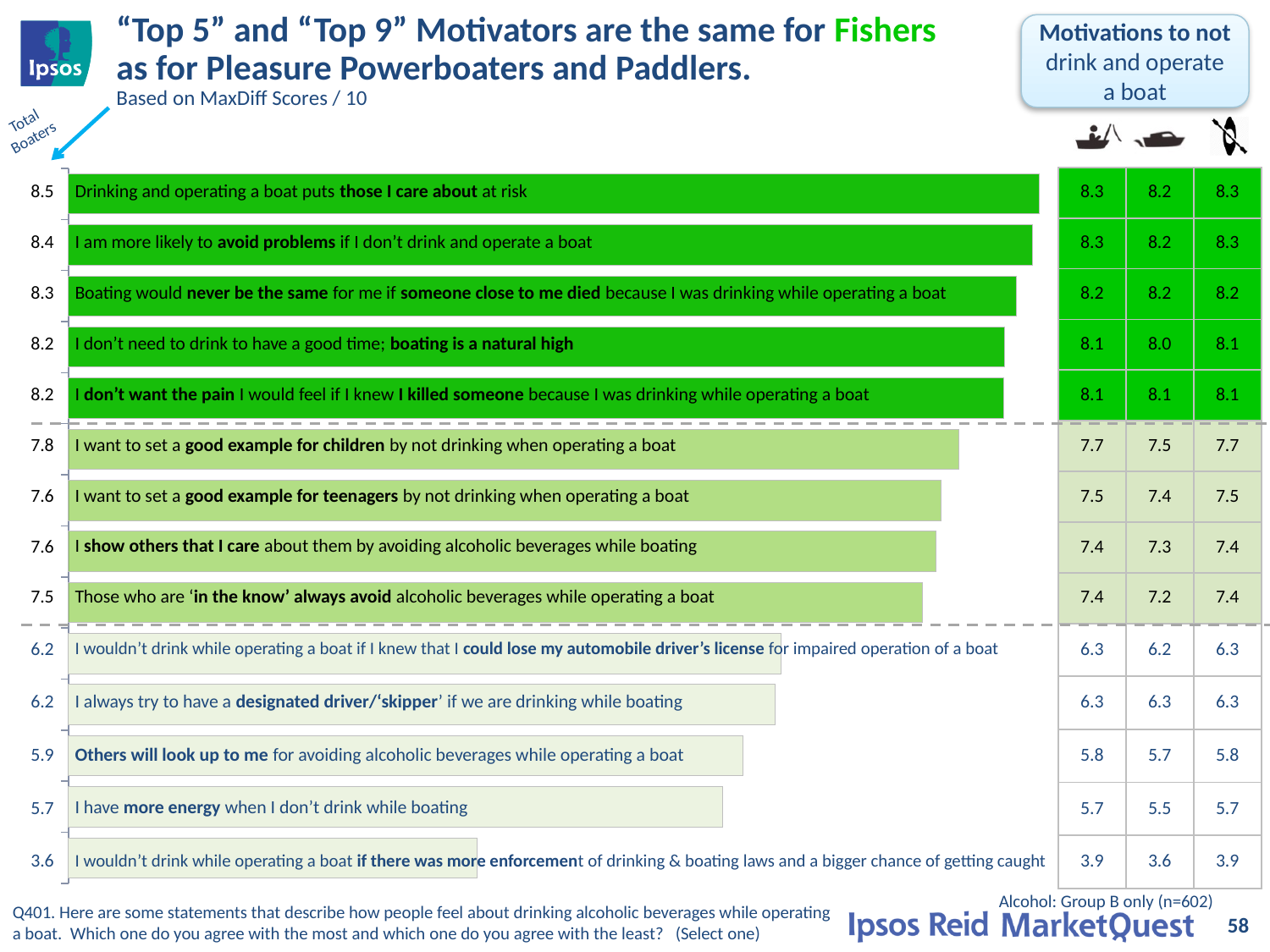
What is the Total Boaters score for 'I want to set a good example for children by not drinking when operating a boat'? 7.8 How many statements (bars) are plotted in the chart? 14 Which statement has the lowest Total Boaters score? I wouldn't drink while operating a boat if there was more enforcement of drinking & boating laws and a bigger chance of getting caught Which statement has the highest Total Boaters score? Drinking and operating a boat puts those I care about at risk What is the difference between the highest Total Boaters score (8.5) and the lowest (3.6)? 4.9 Do the Total Boaters scores rise or fall as you move down the list of statements from top to bottom? fall What is the Total Boaters score for 'I have more energy when I don't drink while boating'? 5.7 What is the Total Boaters score for the statement 'Drinking and operating a boat puts those I care about at risk'? 8.5 Which has a higher Total Boaters score: 'I want to set a good example for children' or 'I always try to have a designated driver/skipper'? I want to set a good example for children According to the subtitle, what are the scores in the chart based on? MaxDiff Scores / 10 What is the difference in Total Boaters score between 'Others will look up to me' (5.9) and 'I have more energy' (5.7)? 0.2 What kind of chart is shown on the slide? bar chart